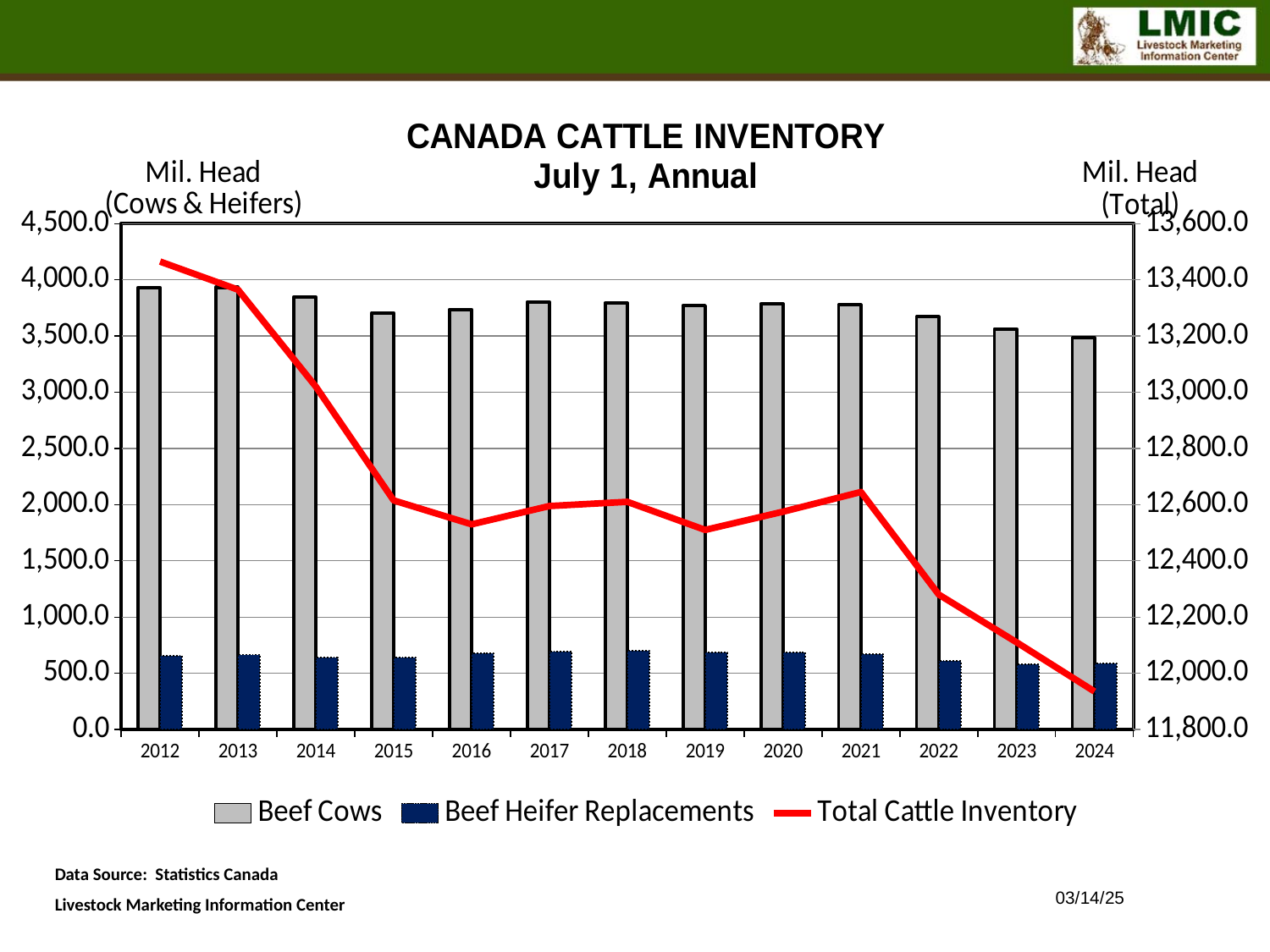
How many years are shown on the x axis? 13 Is the Total Cattle Inventory value for 2024 greater or less than 12,000.0? less Is the Total Cattle Inventory value for 2012 greater or less than 13,000.0? greater In which year is the Beef Cows bar the lowest? 2024 Is the Beef Cows value for 2024 greater or less than 3,000.0? greater What kind of chart is shown on the slide? A combined bar and line chart In which year is the Total Cattle Inventory line at its lowest? 2024 Which is larger, the Beef Cows value for 2014 or for 2015? 2014 Does the Total Cattle Inventory line generally rise or fall from 2012 to 2024? fall How many series does the legend list? 3 In which year is the Total Cattle Inventory line at its highest? 2012